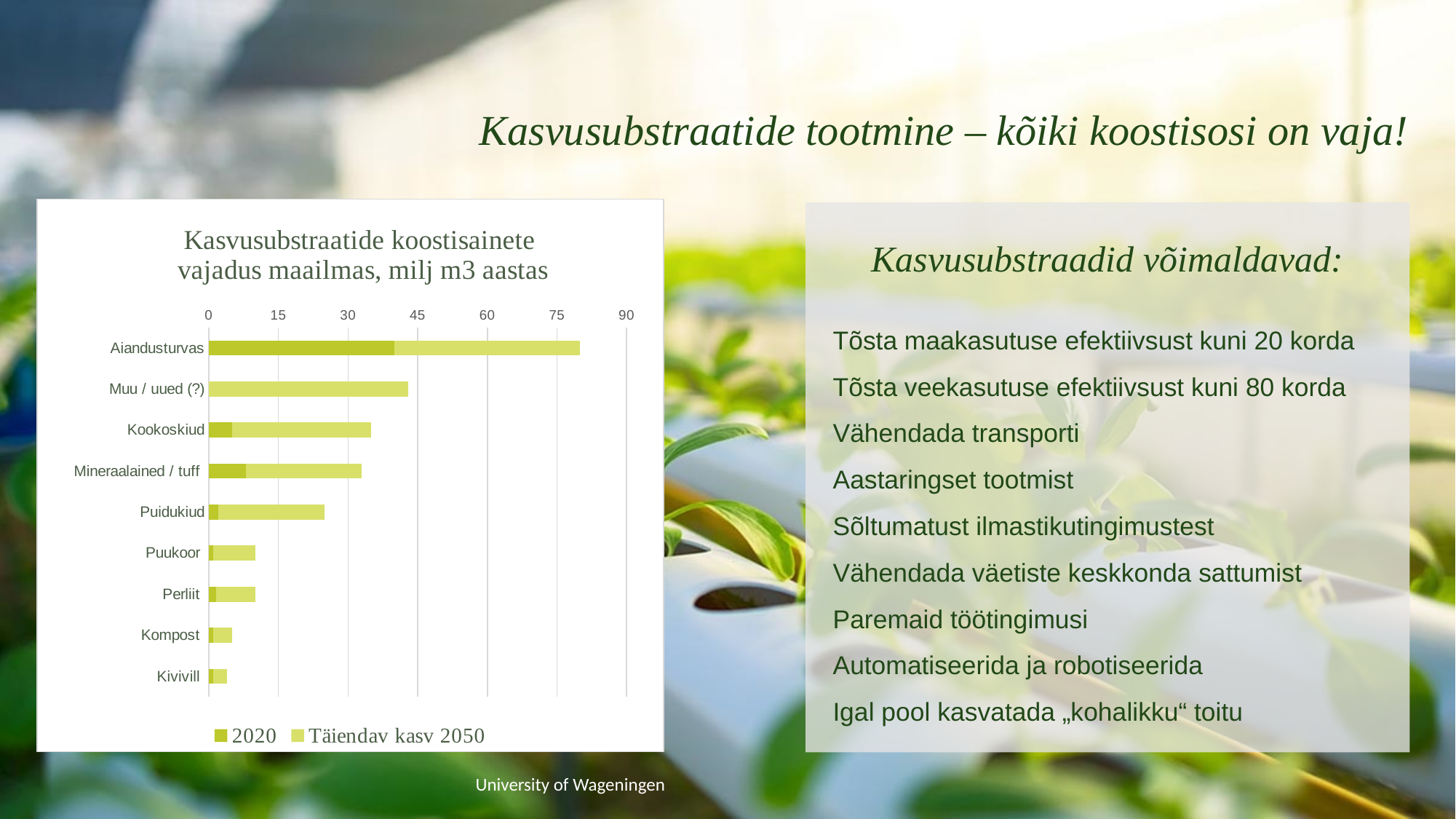
What kind of chart is shown on the slide? bar chart How many categories are shown on the chart? 9 Which has the longer total bar, Aiandusturvas or Muu / uued (?)? Aiandusturvas Is the total bar for Aiandusturvas greater or less than 75? greater What are the two series named in the chart legend? 2020 and Täiendav kasv 2050 Is the total bar for Muu / uued (?) greater or less than 45? less Which category has the longest total bar? Aiandusturvas Is the total bar for Puukoor greater or less than 15? less What is the title of the chart? Kasvusubstraatide koostisainete vajadus maailmas, milj m3 aastas Which has the longer total bar, Kookoskiud or Puidukiud? Kookoskiud How many series does the chart legend list? 2